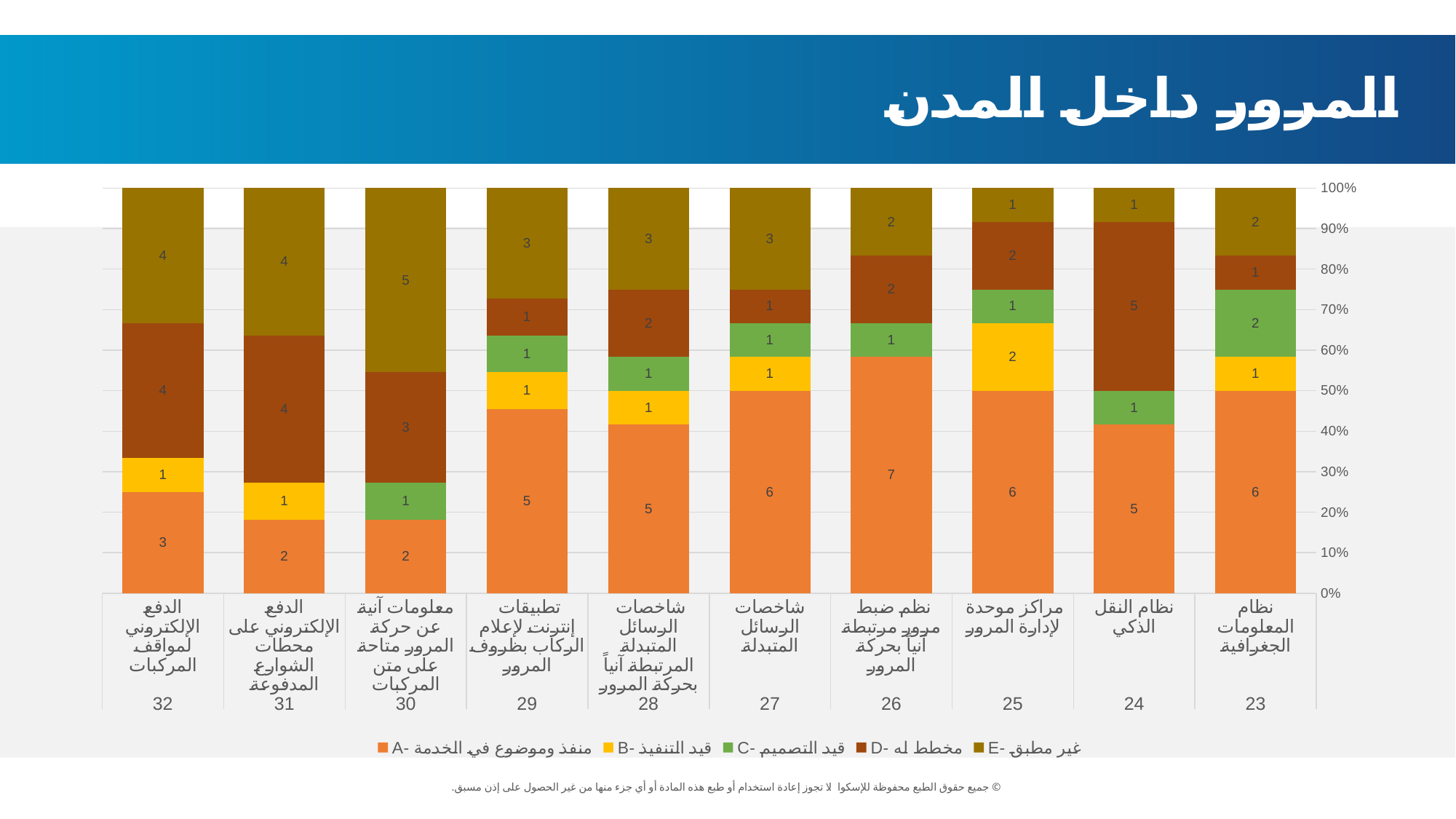
Which category has the highest value for series A (منفذ وموضوع في الخدمة)? 26 (نظم ضبط مرور مرتبطة آنياً بحركة المرور) What is the total of all segments in the bar for category 23 (نظام المعلومات الجغرافية)? 12 What is the total of all segments in the bar for category 29 (تطبيقات إنترنت لإعلام الركاب بظروف المرور)? 11 What is the value of series D (مخطط له) for category 24 (نظام النقل الذكي)? 5 Which is larger: the series A value for category 32 (الدفع الإلكتروني لمواقف المركبات) or for category 31 (الدفع الإلكتروني على محطات الشوارع المدفوعة)? Category 32 How many series does the legend list? 5 What is the title of the slide? المرور داخل المدن How many categories (bars) are shown on the x axis? 10 What is the value of series E (غير مطبق) for category 30 (معلومات آنية عن حركة المرور متاحة على متن المركبات)? 5 What is the value of series A (منفذ وموضوع في الخدمة) for category 26 (نظم ضبط مرور مرتبطة آنياً بحركة المرور)? 7 What is the difference between the series E (غير مطبق) values for category 30 and category 23? 3 What kind of chart is shown on the slide? Stacked bar chart